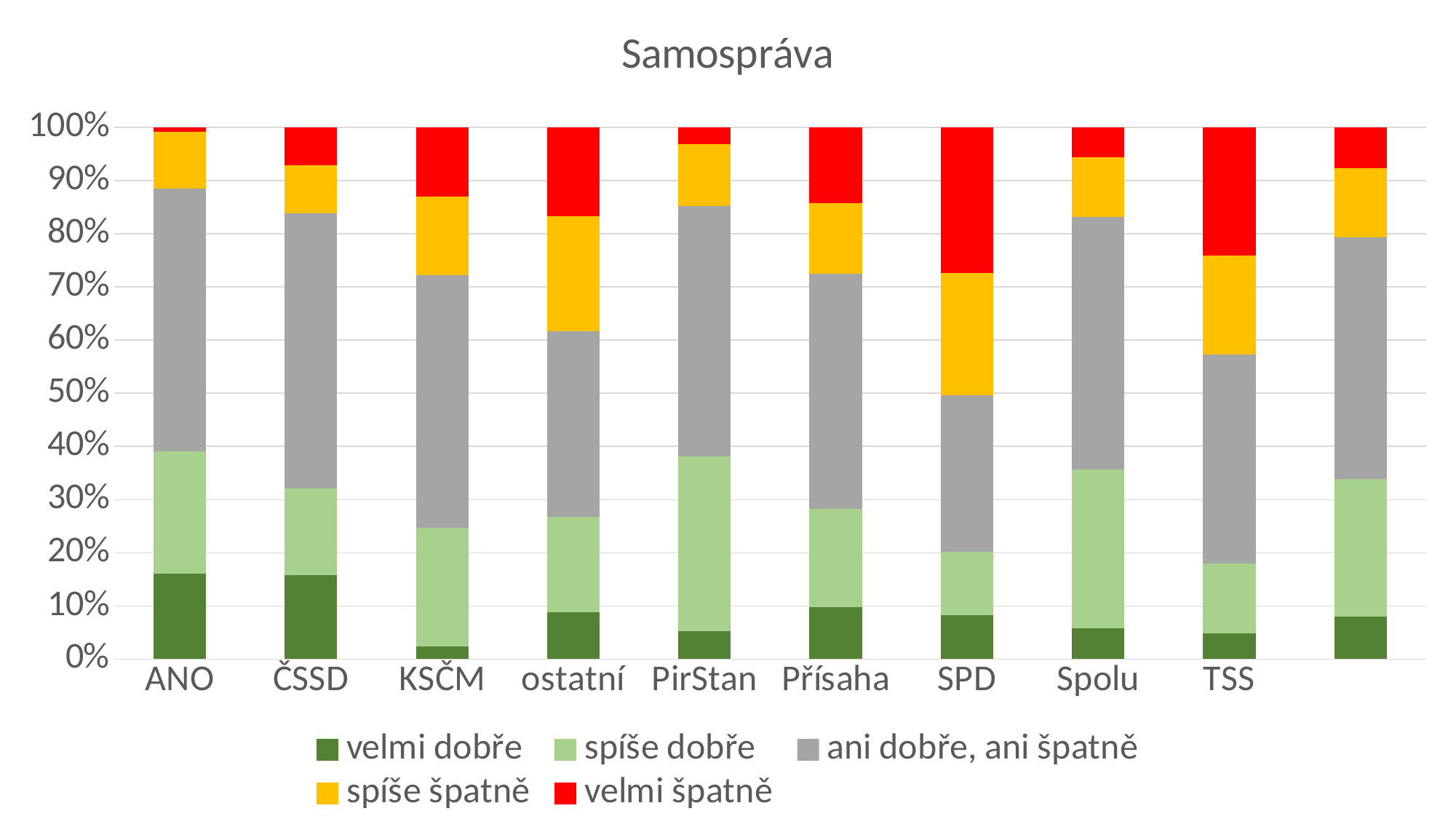
What kind of chart is shown on the slide? stacked bar chart How many series does the legend list? 5 Is the 'velmi dobře' value for ANO greater or less than 10%? greater What is the title of the chart? Samospráva Which has the larger 'velmi špatně' segment, SPD or PirStan? SPD Which category has the smallest 'velmi dobře' segment? KSČM Which category has the smallest 'velmi špatně' segment? ANO Is the 'velmi dobře' value for KSČM greater or less than 10%? less Is the 'velmi dobře' value for Spolu greater or less than 10%? less Which colour represents 'velmi špatně' in the legend? red How many bars are plotted in the chart? 10 Which category has the largest 'spíše špatně' segment? SPD